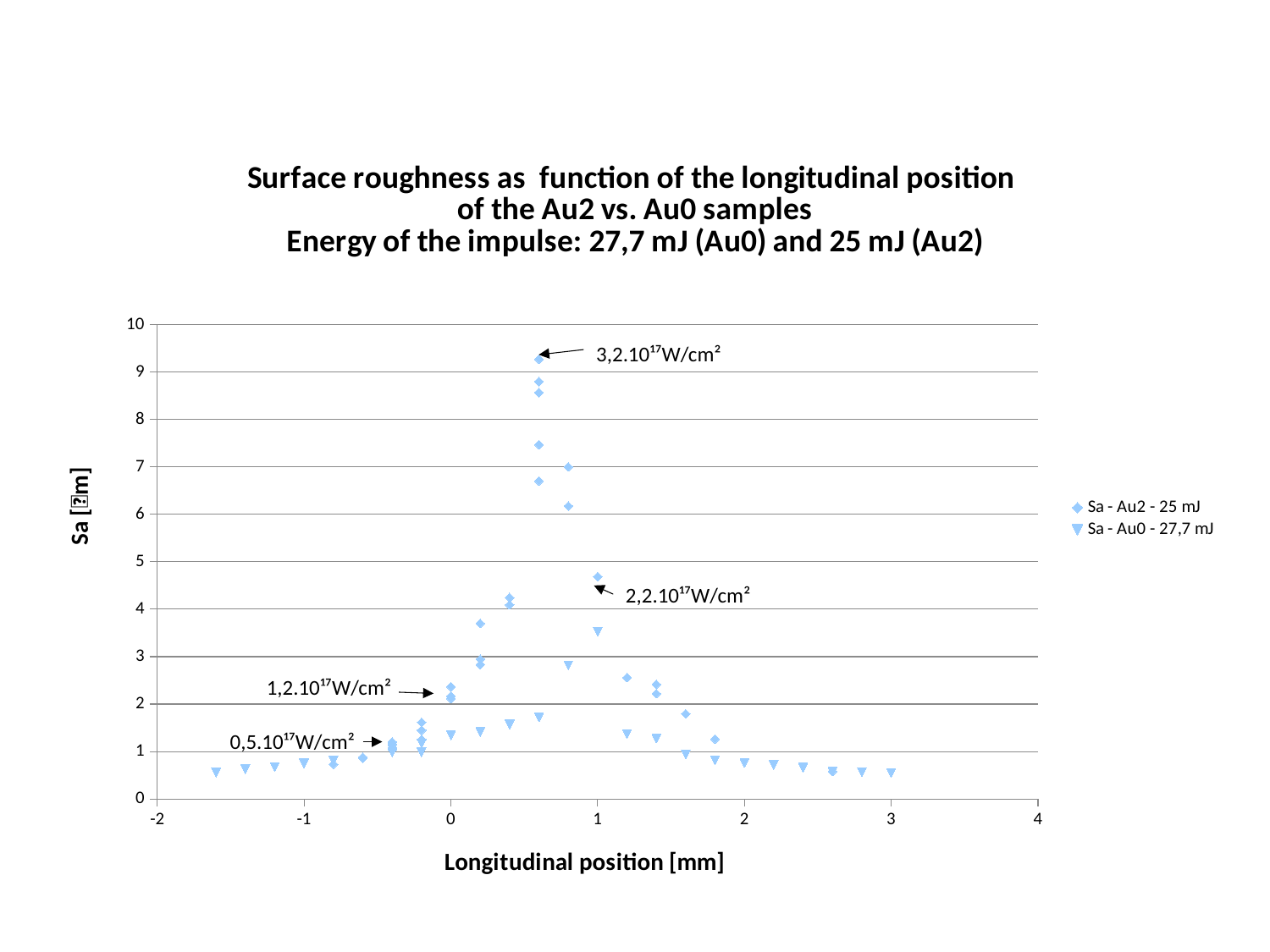
At longitudinal position 1 mm, which series has the higher Sa value? Sa - Au2 - 25 mJ What is the label of the x axis? Longitudinal position [mm] Is the highest value of the Sa - Au2 - 25 mJ series greater or less than 9? greater Is the value of the Sa - Au0 - 27,7 mJ series at longitudinal position -1.6 mm greater or less than 1? less What are the two series names in the legend? Sa - Au2 - 25 mJ and Sa - Au0 - 27,7 mJ Is the value of the Sa - Au0 - 27,7 mJ series at longitudinal position 1 mm greater or less than 3? greater Do the values of the Sa - Au0 - 27,7 mJ series rise or fall as the longitudinal position increases from 1 mm to 3 mm? fall What kind of chart is shown on the slide? scatter chart Which series reaches the highest Sa value on the chart? Sa - Au2 - 25 mJ How many series does the legend list? 2